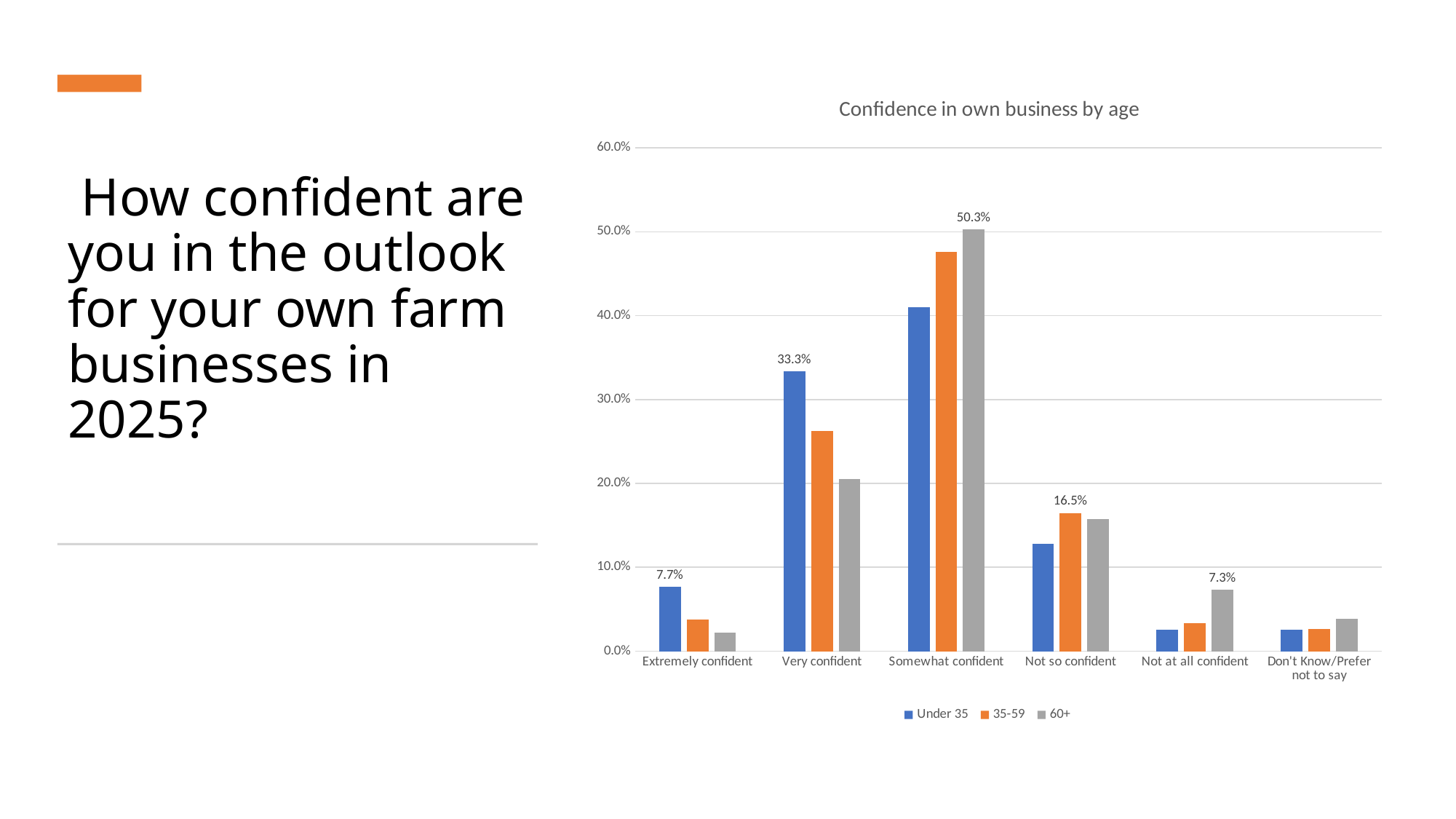
Which age group has the highest value in the Somewhat confident category? 60+ How many categories are shown on the x axis of the chart? 6 How many series does the chart legend list? 3 Which is larger in the Extremely confident category: the value for Under 35 or the value for 60+? Under 35 What is the value for 60+ in the Somewhat confident category? 50.3% What is the value for Under 35 in the Very confident category? 33.3% What is the value for 60+ in the Not at all confident category? 7.3% What is the value for 35-59 in the Not so confident category? 16.5% What is the value for Under 35 in the Extremely confident category? 7.7% What kind of chart is shown on the slide? Bar chart Is the value for 35-59 in the Very confident category greater or less than 20.0%? greater What is the title of the chart? Confidence in own business by age